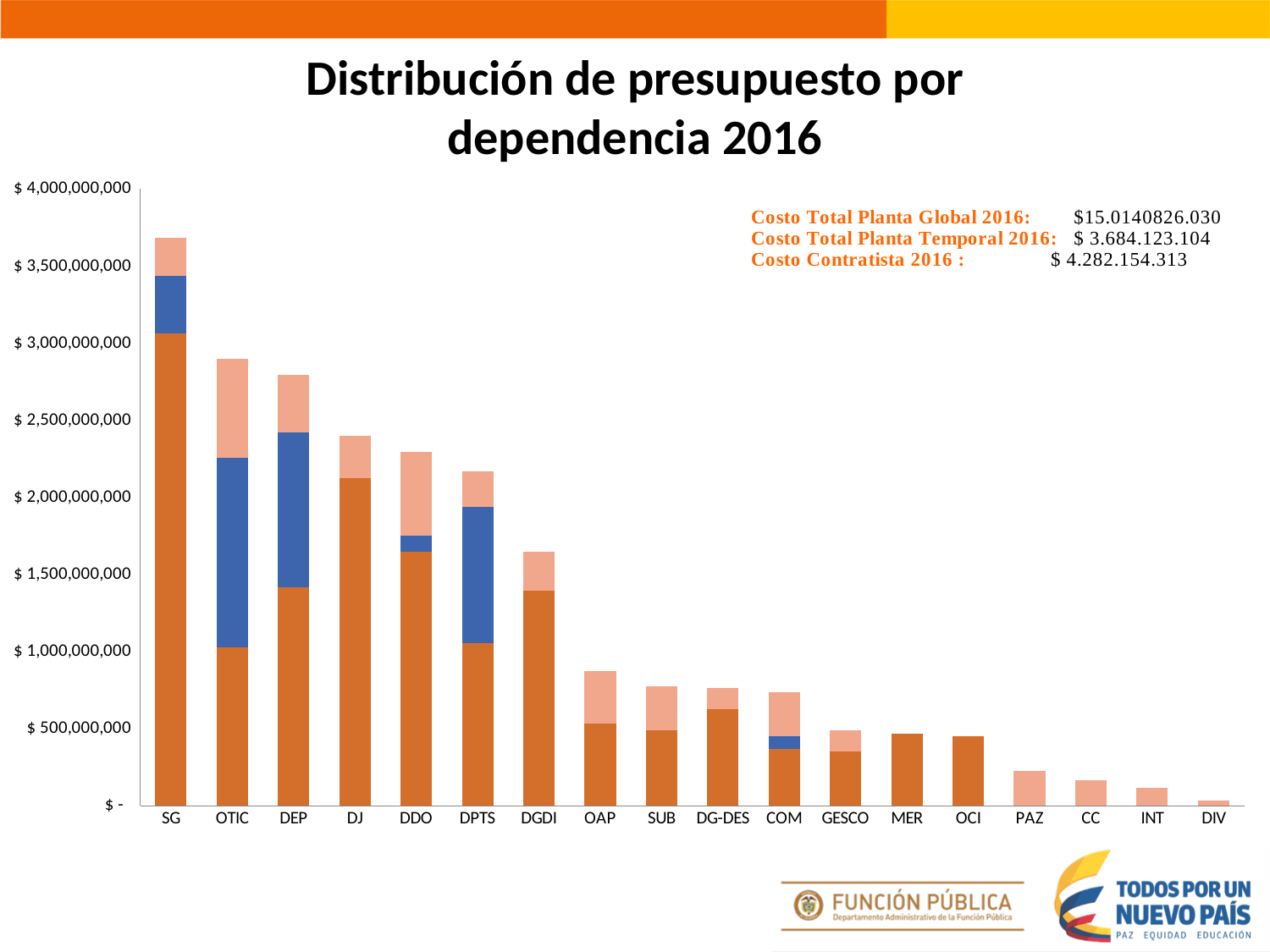
Do the total bar values generally rise or fall from left to right along the x axis? fall How many dependencias (categories) are shown on the x axis? 18 Is the total value for DGDI greater or less than $1,500,000,000? greater Which dependencia has the lowest total bar? DIV Is the total value for PAZ greater or less than $500,000,000? less Is the total value for OAP greater or less than $1,000,000,000? less What is the title of the chart? Distribución de presupuesto por dependencia 2016 Which dependencia has the highest total bar? SG What kind of chart is shown on the slide? Stacked bar chart Which has the larger total bar, SG or OTIC? SG